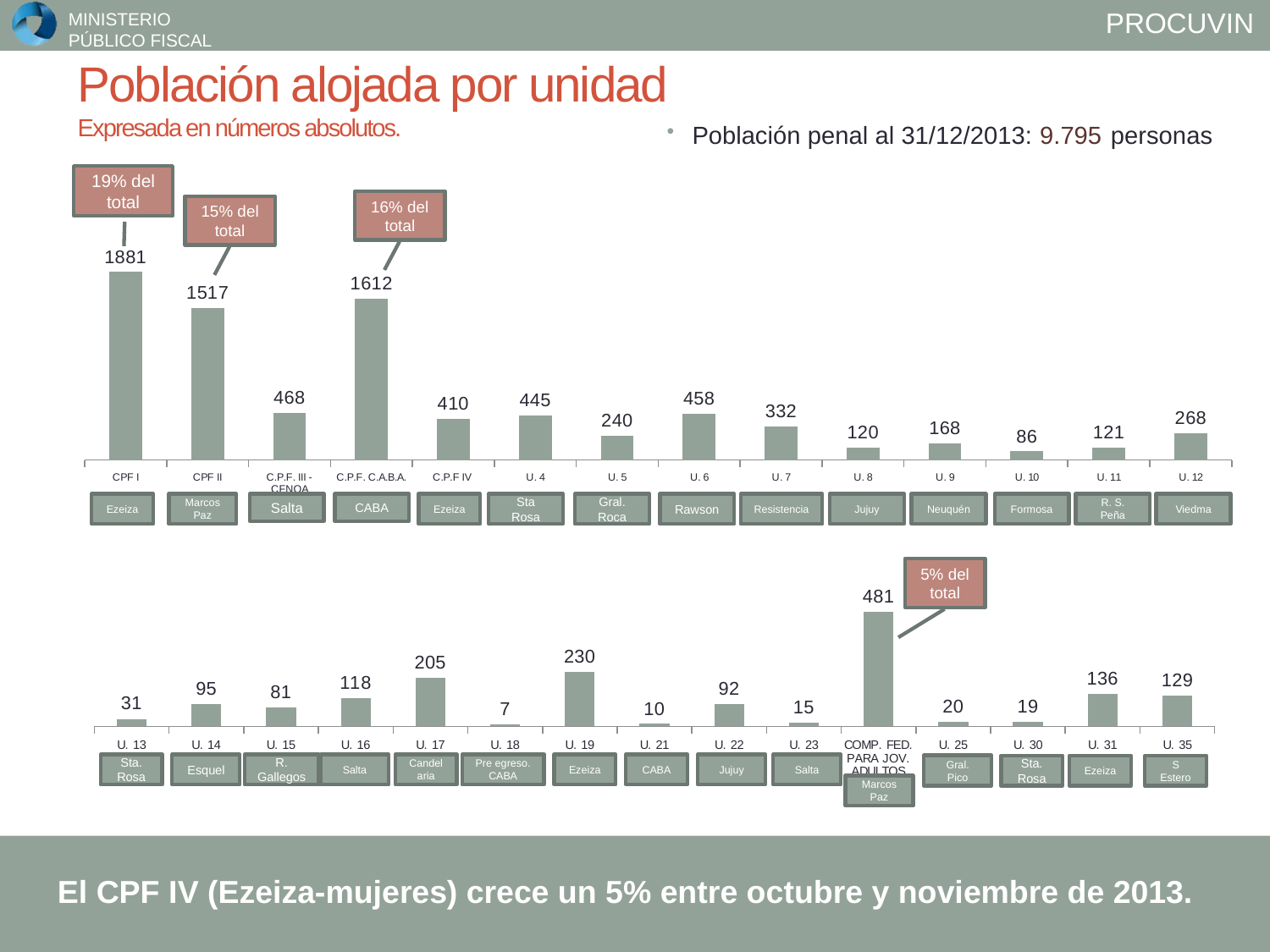
In the top chart, what is the value for CPF I? 1881 In the bottom chart, which category has the highest value? COMP. FED. PARA JOV. ADULTOS In the top chart, which is larger, U. 4 or U. 6? U. 6 In the bottom chart, what is the difference between U. 31 and U. 35? 7 In the top chart, what is the value for U. 7? 332 In the bottom chart, what is the value for U. 19? 230 In the top chart, which category has the lowest value? U. 10 In the bottom chart, which category has the lowest value? U. 18 How many categories are shown in the bottom chart? 15 In the top chart, what is the difference between CPF I and CPF II? 364 What type of chart is the top chart? Bar chart How many categories are shown in the top chart? 14